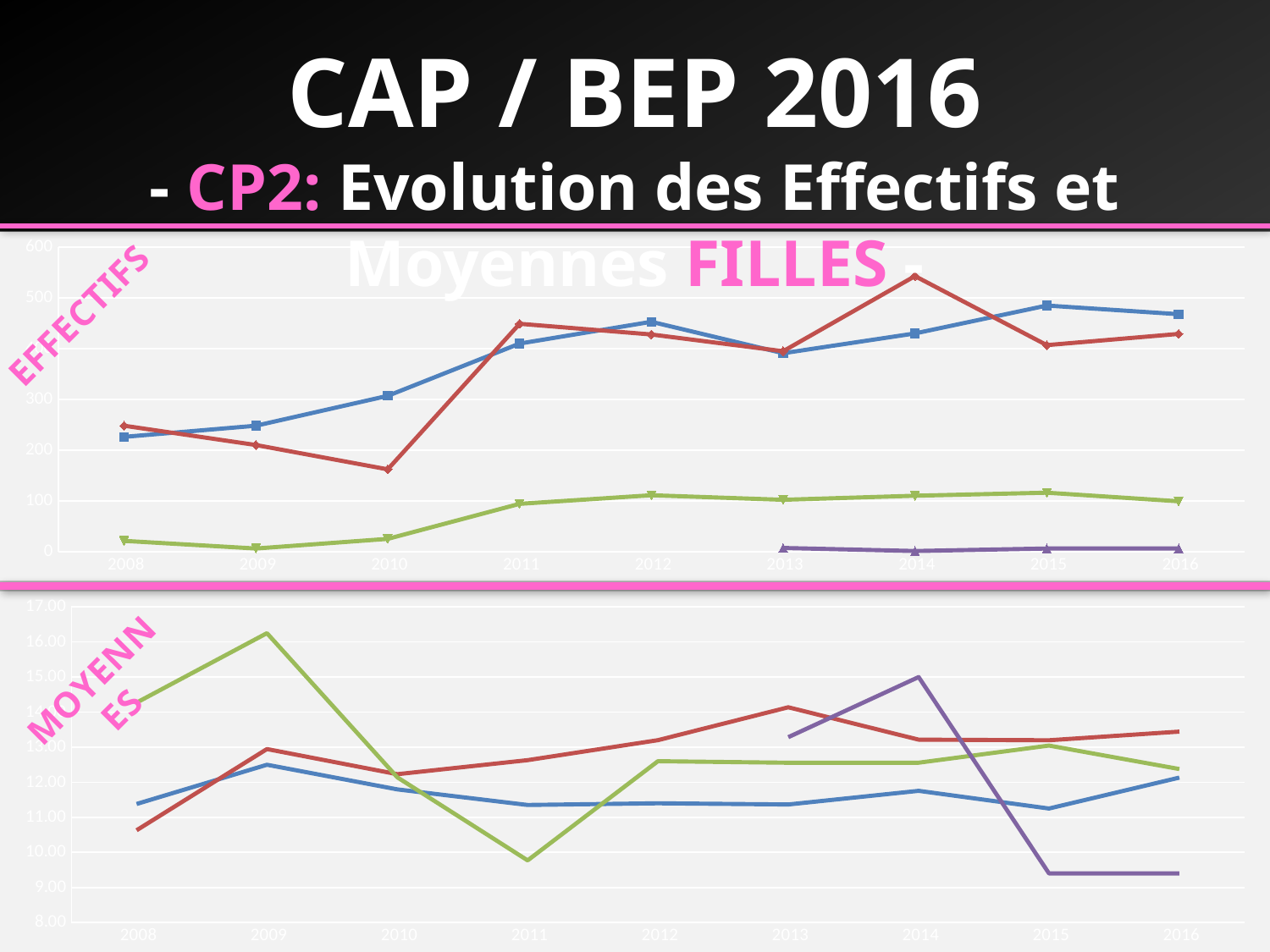
In the top chart (EFFECTIFS), how many years are shown on the x axis? 9 In the bottom chart (MOYENNES), in which year does the green line reach its highest value? 2009 In the bottom chart (MOYENNES), is the value of the purple line in 2014 greater or less than 14.00? greater In the top chart (EFFECTIFS), in which year does the purple line first appear? 2013 What kind of chart is the bottom chart labelled MOYENNES? line chart In the top chart (EFFECTIFS), in which year does the red line reach its highest value? 2014 In the top chart (EFFECTIFS), does the blue line rise or fall from 2008 to 2012? rise In the top chart (EFFECTIFS), is the value of the red line in 2014 greater or less than 500? greater In the top chart (EFFECTIFS), which line is higher in 2012, the blue line or the red line? blue What kind of chart is the top chart labelled EFFECTIFS? line chart In the top chart (EFFECTIFS), is the value of the red line in 2010 greater or less than 200? less